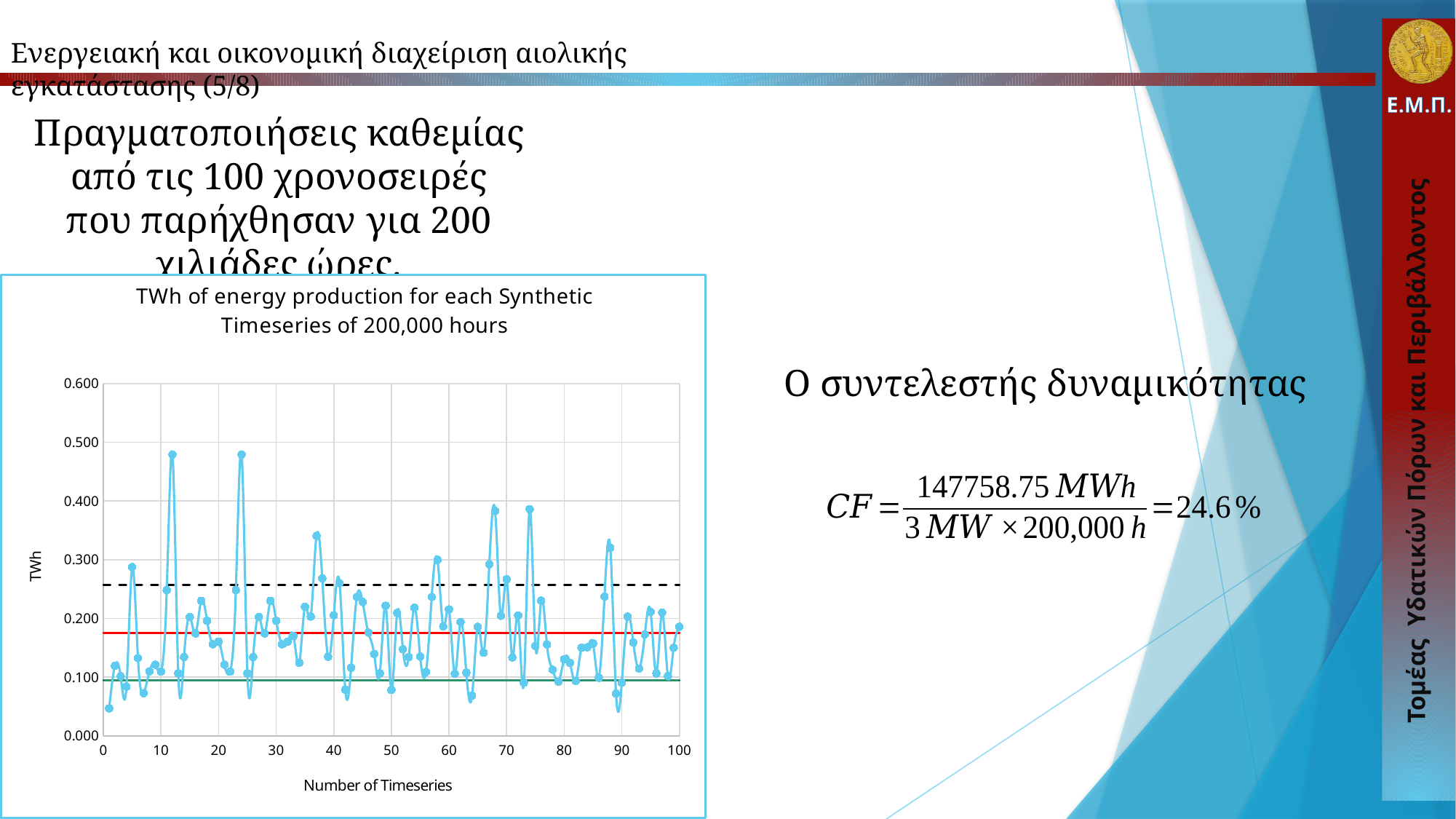
Which has the larger value, timeseries 37 or timeseries 64? timeseries 37 Is the value for timeseries 12 greater or less than 0.400? greater What is the label of the x axis of the chart? Number of Timeseries What kind of chart is shown on the slide? line chart What is the title of the chart? TWh of energy production for each Synthetic Timeseries of 200,000 hours Is the value for timeseries 37 greater or less than 0.300? greater Is the value for timeseries 64 greater or less than 0.100? less Which has the larger value, timeseries 12 or timeseries 1? timeseries 12 How many synthetic timeseries are plotted on the chart? 100